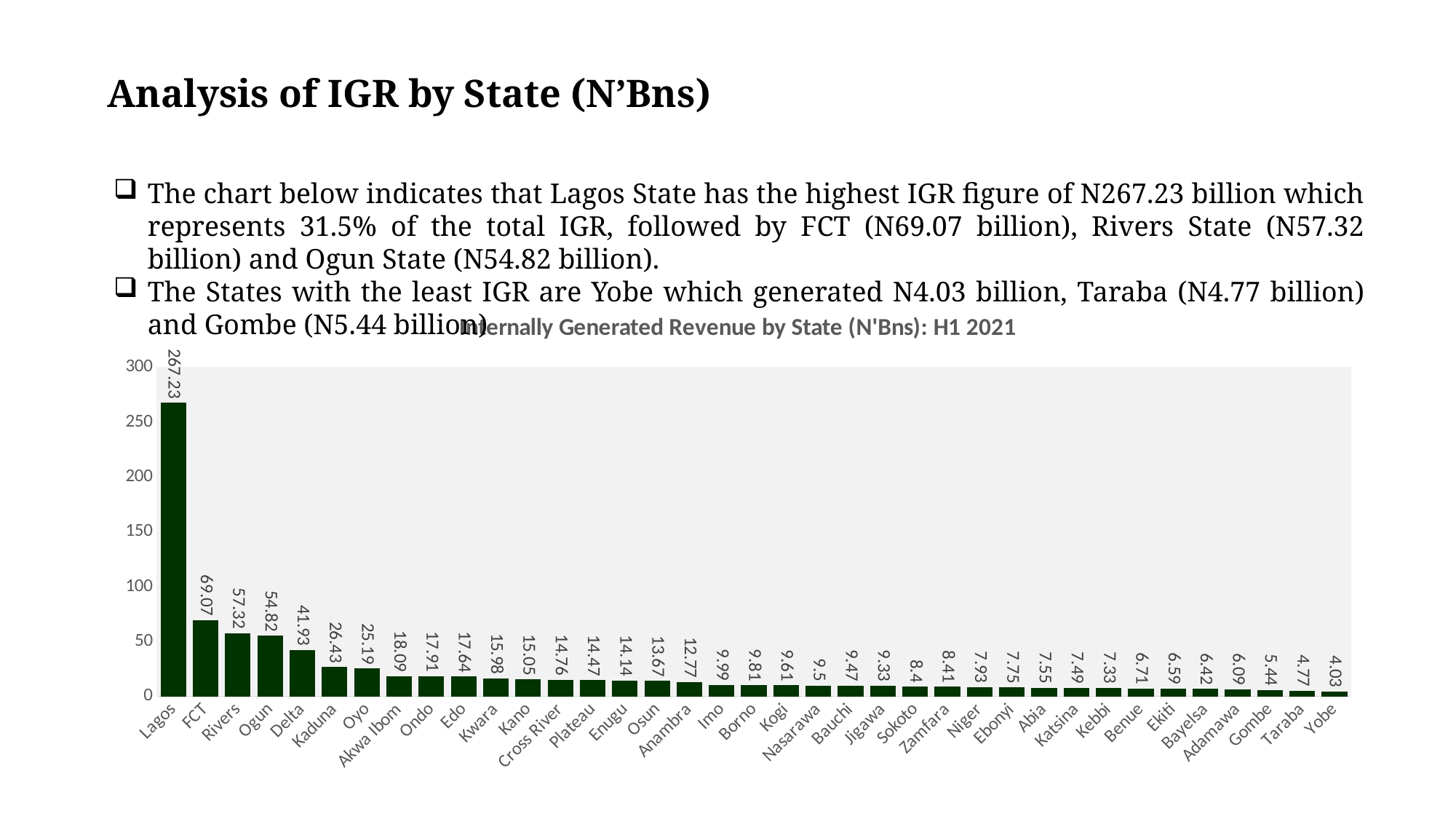
What is the difference between the IGR values of Rivers and Ogun? 2.5 Which state has the highest IGR in the chart? Lagos What is the IGR value shown for Taraba? 4.77 What is the IGR value shown for Delta? 41.93 Which has a larger IGR value, Kaduna or Oyo? Kaduna Do the IGR values rise or fall moving from left to right along the x axis? Fall What is the difference between the IGR values of Lagos and FCT? 198.16 What is the IGR value shown for Lagos? 267.23 What type of chart is shown on the slide? Bar chart How many states are shown in the chart? 37 Which state has the lowest IGR in the chart? Yobe What is the IGR value shown for Kano? 15.05